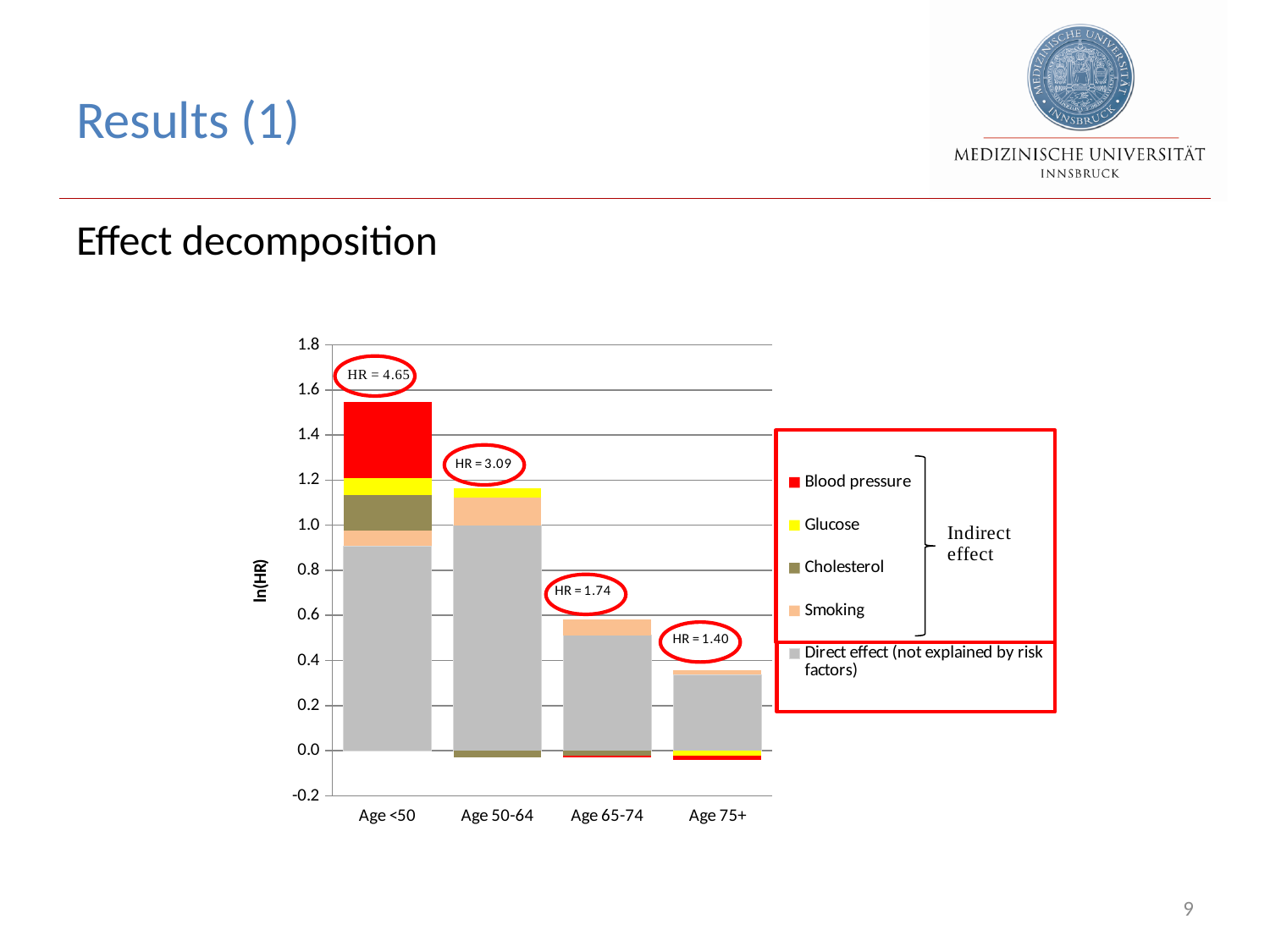
How many series does the chart's legend list? 5 How many age categories are shown on the x axis of the chart? 4 What colour represents Blood pressure in the legend? Red What HR value is annotated above the bar for Age 75+? 1.40 What HR value is annotated above the bar for Age 50-64? 3.09 Which age category has the shortest stacked bar? Age 75+ Do the bar heights rise or fall as age increases along the x axis? Fall Which age category has the tallest stacked bar? Age <50 What kind of chart is shown on the slide? Stacked bar chart What HR value is annotated above the bar for Age <50? 4.65 Is the top of the stacked bar for Age <50 greater or less than 1.4 on the ln(HR) axis? greater